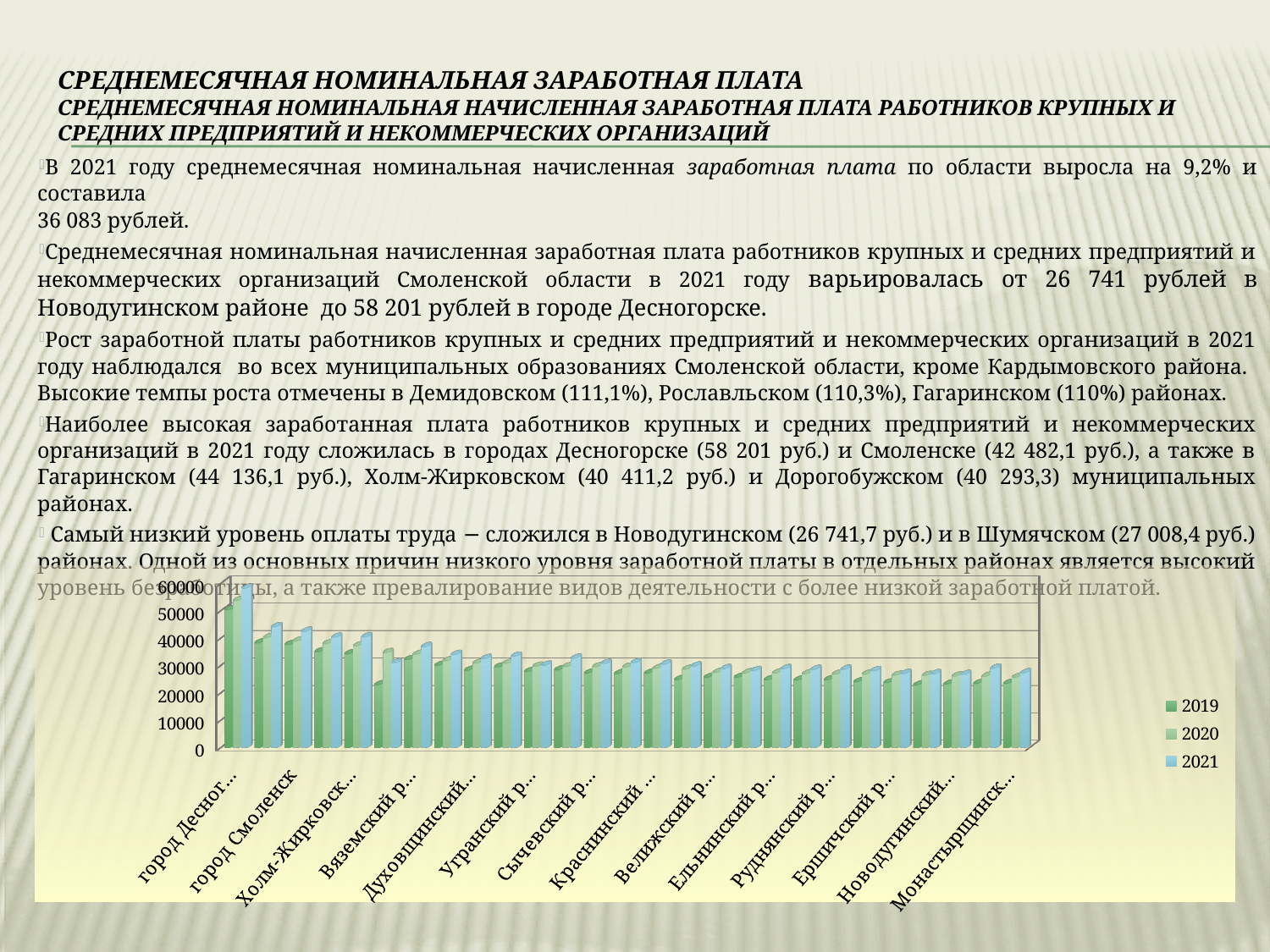
Do the 2021 values generally rise or fall moving from left to right along the x axis? fall Is the 2021 value for Монастырщинский район greater or less than 40000? less Is the 2021 value for Новодугинский район greater or less than 30000? less Is the 2021 value for город Смоленск greater or less than 30000? greater For город Смоленск, which is larger: the 2019 value or the 2021 value? 2021 Which series is shown in light blue in the chart? 2021 What kind of chart is shown on the slide? bar chart Which has the larger 2021 value: город Смоленск or Новодугинский район? город Смоленск How many series does the chart legend list? 3 Which years are listed in the chart legend? 2019, 2020, 2021